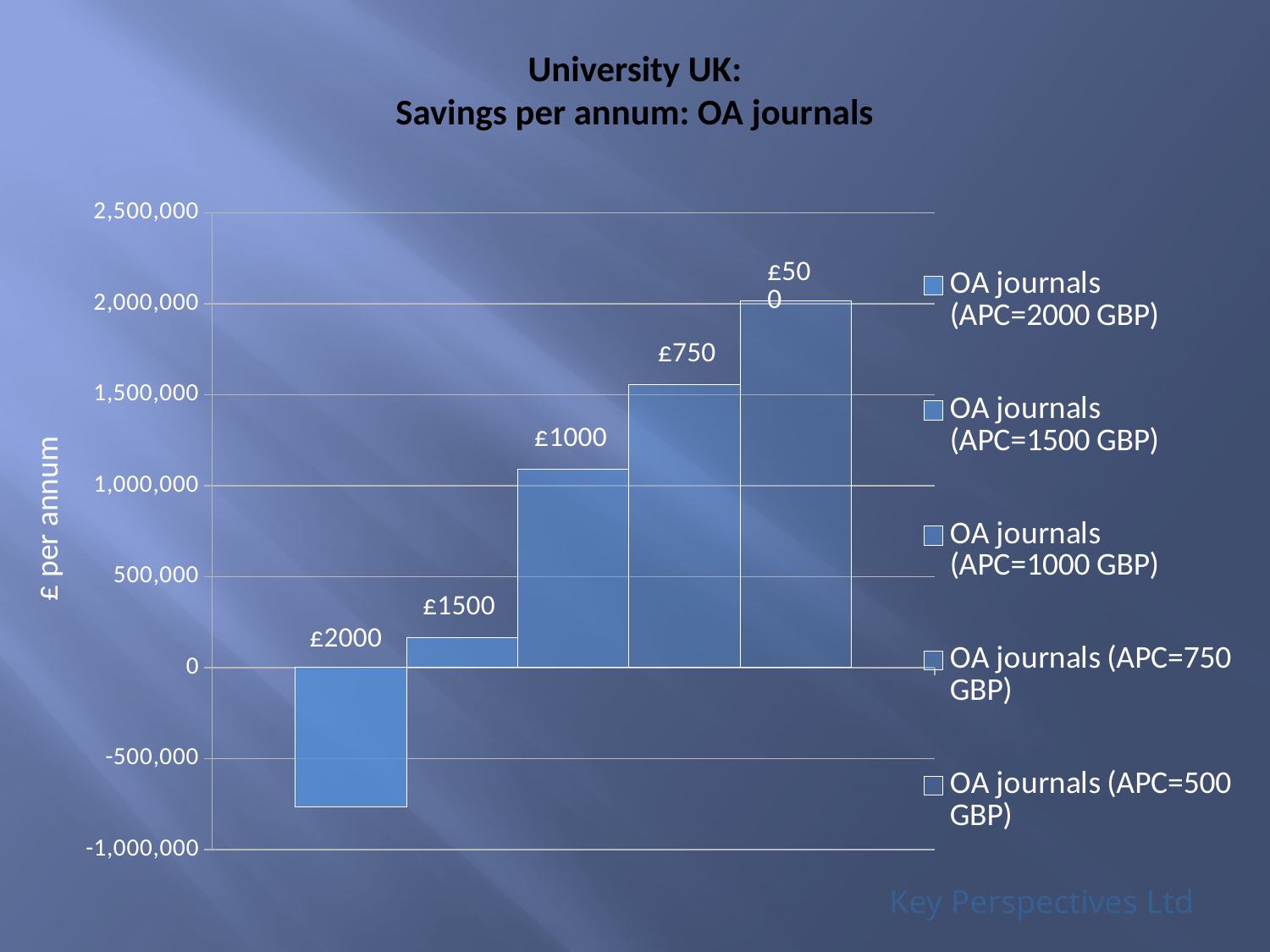
Is the value for the £1000 APC bar greater or less than 1,000,000? greater Is the value for the £1500 APC bar greater or less than 500,000? less Which is larger, the savings for the £750 APC bar or the £1000 APC bar? £750 APC bar Which bar shows the lowest savings per annum? £2000 (OA journals APC=2000 GBP) What kind of chart is shown on the slide? bar chart What is the title of the chart? University UK: Savings per annum: OA journals Is the value for the £2000 APC bar greater or less than -500,000? less Do the savings rise or fall as the APC decreases from £2000 to £500 along the x axis? rise Which bar shows the highest savings per annum? £500 (OA journals APC=500 GBP) How many series does the legend list? 5 How many bars are plotted in the chart? 5